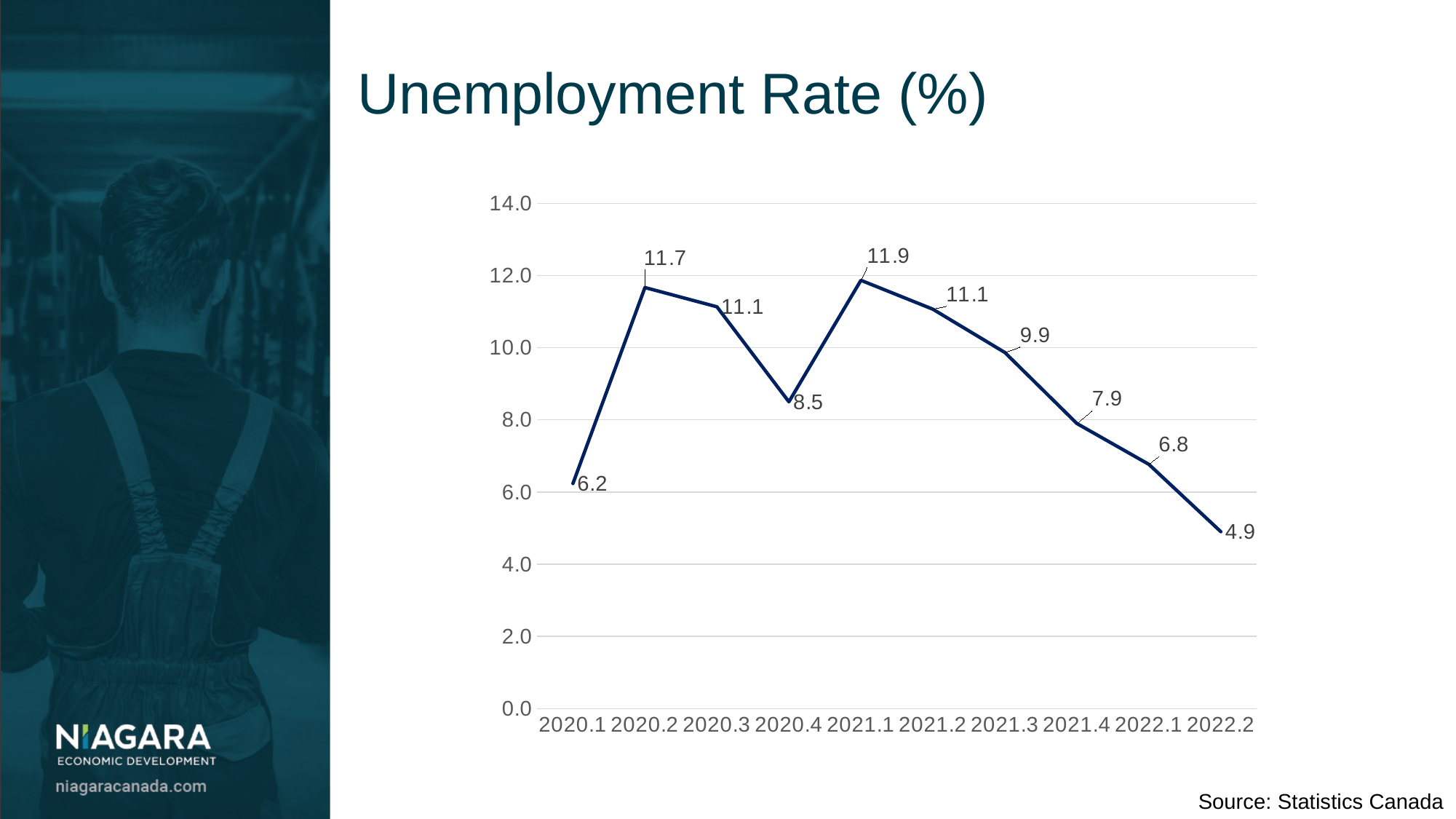
Which is higher, the unemployment rate in 2020.2 or in 2021.3? 2020.2 What is the unemployment rate for 2020.1? 6.2 Which period has the lowest unemployment rate? 2022.2 What is the unemployment rate for 2020.4? 8.5 What is the difference between the unemployment rate in 2021.1 and in 2022.2? 7.0 Is the unemployment rate for 2021.4 greater or less than 8.0? less What is the unemployment rate for 2021.1? 11.9 What kind of chart is shown on the slide? line chart How many periods are plotted on the x axis? 10 What is the unemployment rate for 2022.2? 4.9 From 2021.1 to 2022.2, does the unemployment rate rise or fall? fall Which period has the highest unemployment rate? 2021.1